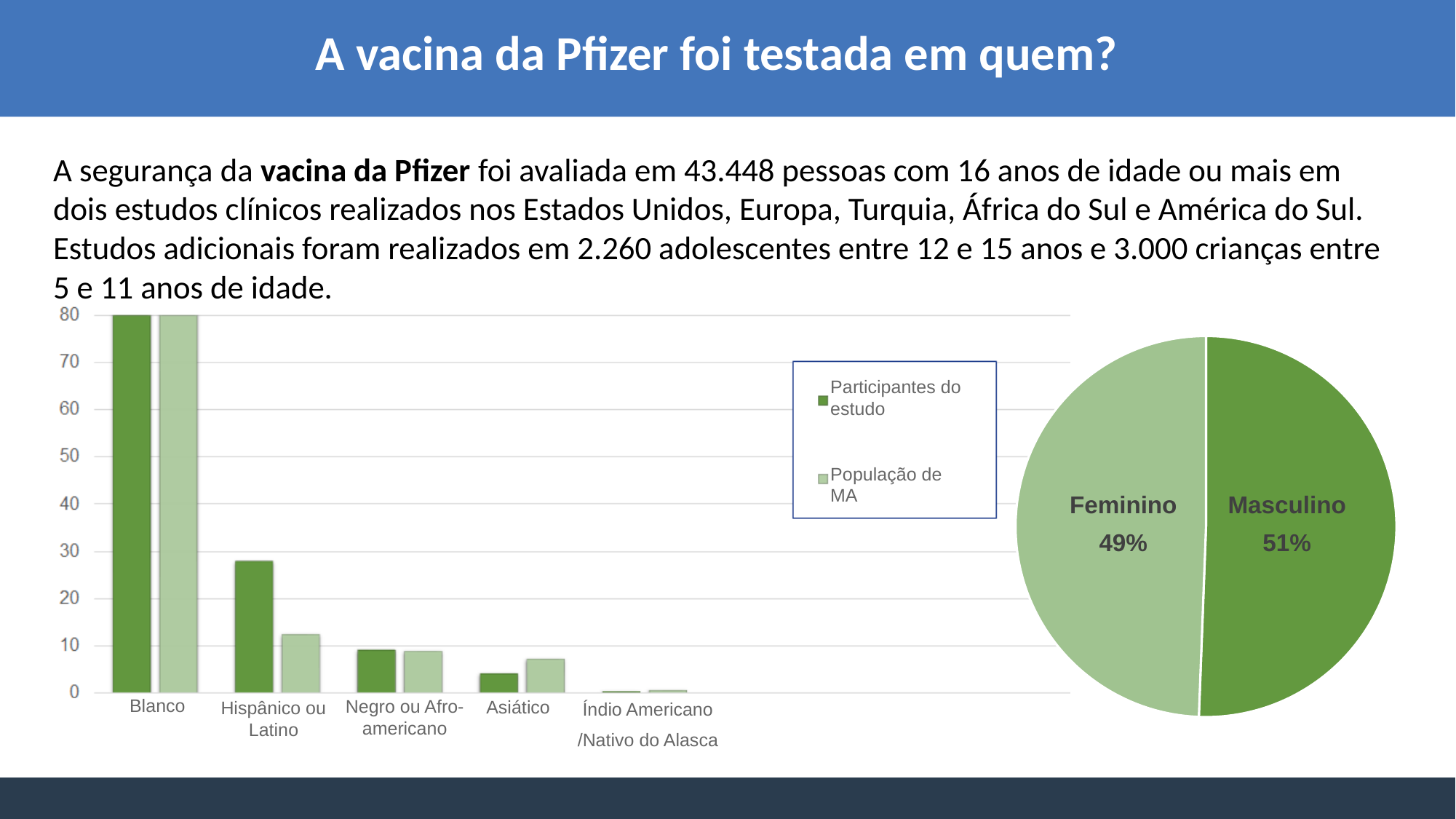
What kind of chart is the chart on the right of the slide? pie chart In the bar chart on the left, for Hispânico ou Latino, which is larger: Participantes do estudo or População de MA? Participantes do estudo In the pie chart on the right, which slice is larger: Feminino or Masculino? Masculino In the bar chart on the left, which category has the lowest value for População de MA? Índio Americano/Nativo do Alasca In the bar chart on the left, is the Participantes do estudo value for Asiático greater or less than 10? less In the pie chart on the right, what share is Feminino? 49% What kind of chart is the chart on the left of the slide? bar chart In the bar chart on the left, how many categories are shown on the x axis? 5 In the bar chart on the left, how many series does the legend list? 2 In the bar chart on the left, is the Participantes do estudo value for Blanco greater or less than 70? greater In the bar chart on the left, is the Participantes do estudo value for Hispânico ou Latino greater or less than 20? greater In the bar chart on the left, which category has the highest value for Participantes do estudo? Blanco